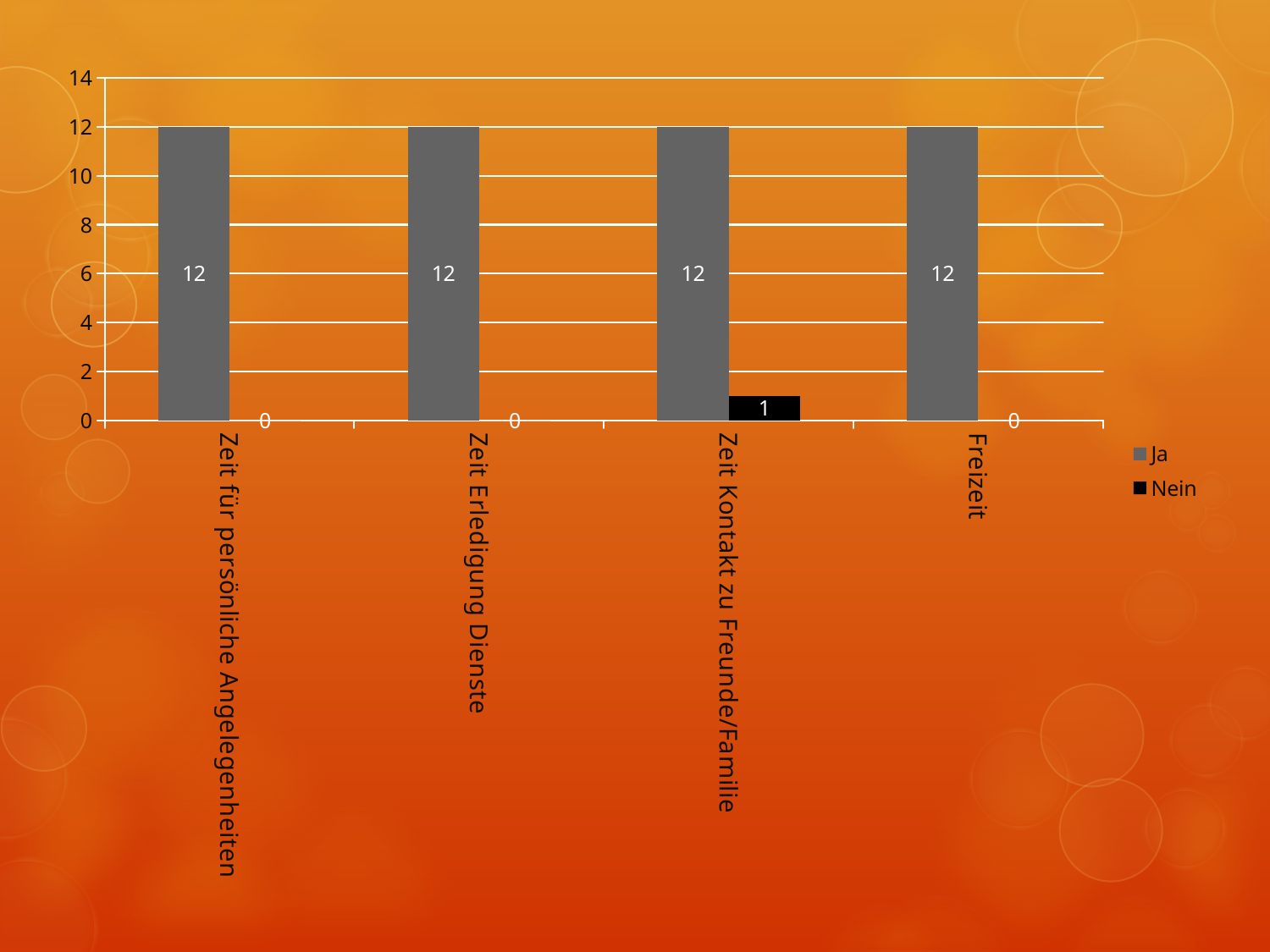
How many series does the legend list? 2 What is the difference between the Ja and Nein values for Zeit Kontakt zu Freunde/Familie? 11 What are the two entries listed in the legend? Ja and Nein Is the Ja value for Zeit Erledigung Dienste greater or less than 10? greater What is the value of the Ja series for Zeit für persönliche Angelegenheiten? 12 What is the value of the Ja series for Freizeit? 12 What is the value of the Nein series for Zeit Kontakt zu Freunde/Familie? 1 What kind of chart is shown on the slide? bar chart Which is larger for Freizeit, the Ja value or the Nein value? Ja Which category has the highest value in the Nein series? Zeit Kontakt zu Freunde/Familie What is the value of the Nein series for Zeit Erledigung Dienste? 0 How many categories are shown on the x axis? 4